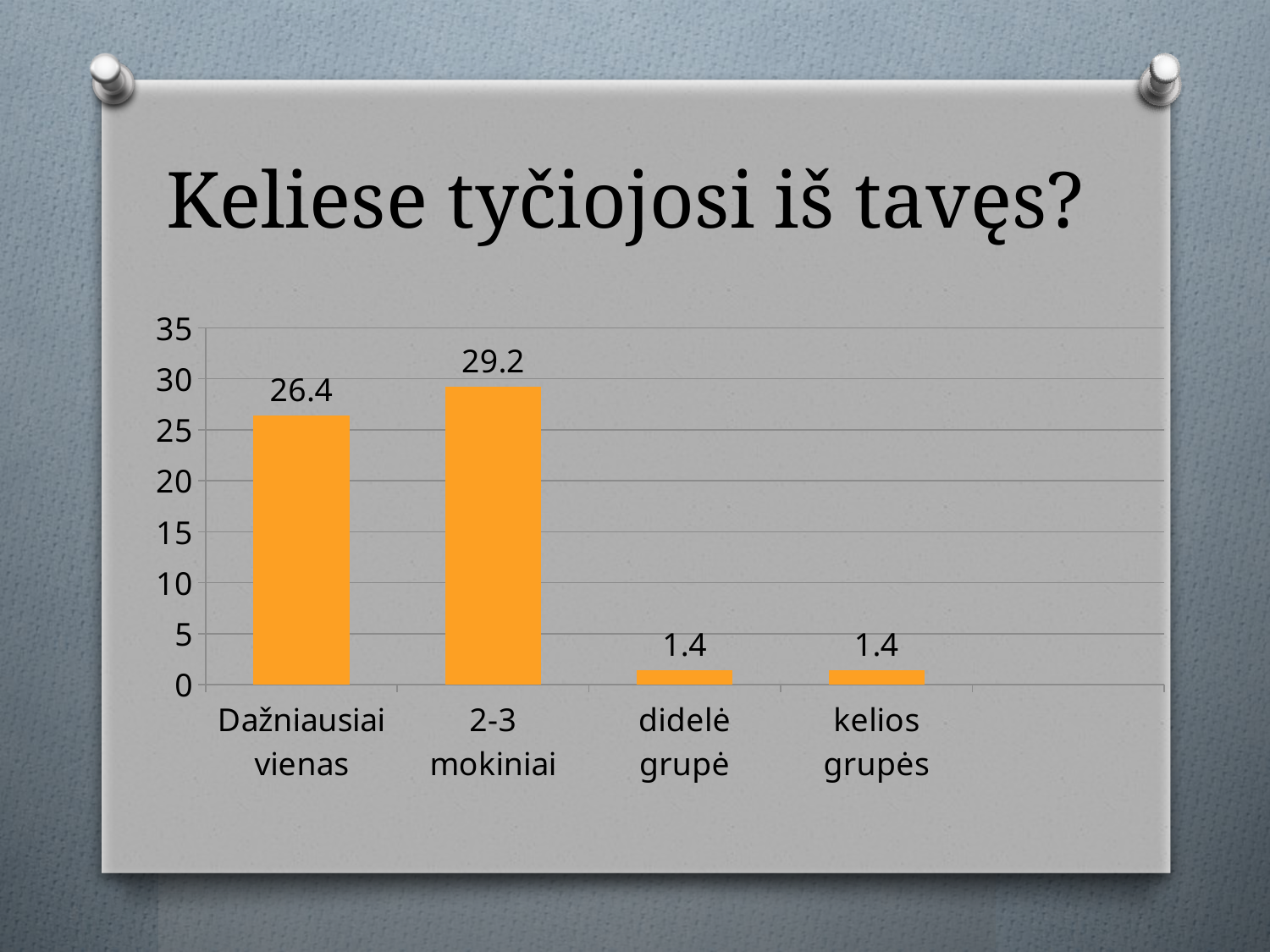
What is the value for "didelė grupė"? 1.4 How many categories are shown on the x axis? 4 Is the value for "2-3 mokiniai" greater or less than 25? greater What is the title of the slide? Keliese tyčiojosi iš tavęs? Which is larger, the value for "Dažniausiai vienas" or the value for "2-3 mokiniai"? 2-3 mokiniai What is the value for "kelios grupės"? 1.4 What is the difference between the values for "2-3 mokiniai" and "Dažniausiai vienas"? 2.8 Which category has the highest value? 2-3 mokiniai What is the value for "2-3 mokiniai"? 29.2 What is the value for "Dažniausiai vienas"? 26.4 What is the difference between the values for "Dažniausiai vienas" and "didelė grupė"? 25.0 What kind of chart is shown on the slide? bar chart